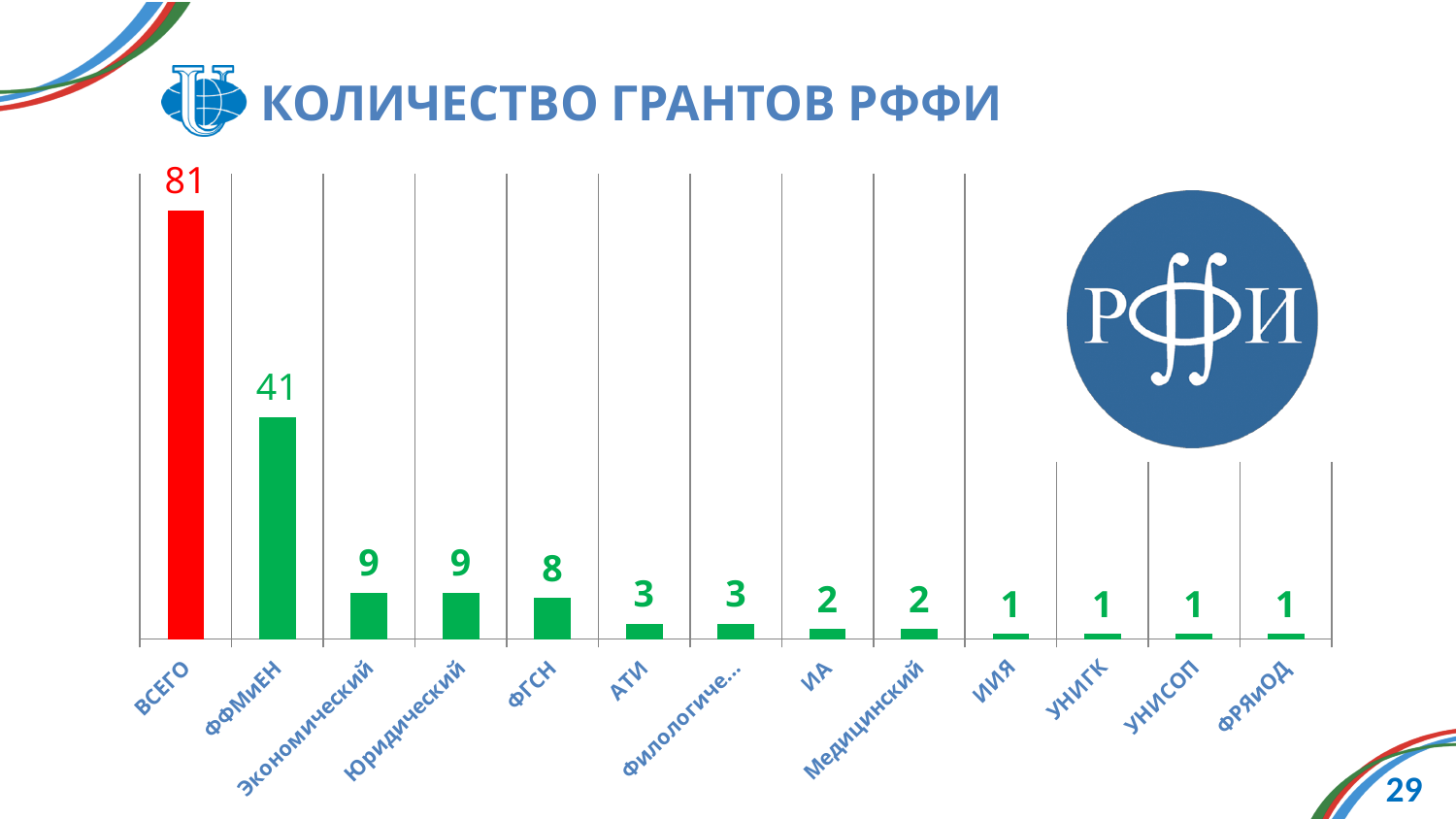
What is the value for ВСЕГО? 81 Which is larger, the value for ФГСН or the value for ИА? ФГСН What is the title of the chart? КОЛИЧЕСТВО ГРАНТОВ РФФИ How many categories are shown on the x axis? 13 What is the difference between the values for ВСЕГО and ФФМиЕН? 40 What type of chart is shown on the slide? bar chart What is the value for ФФМиЕН? 41 Which category has the highest value? ВСЕГО What is the value for ФГСН? 8 What is the value for Медицинский? 2 What is the difference between the values for Экономический and АТИ? 6 What is the value for УНИСОП? 1